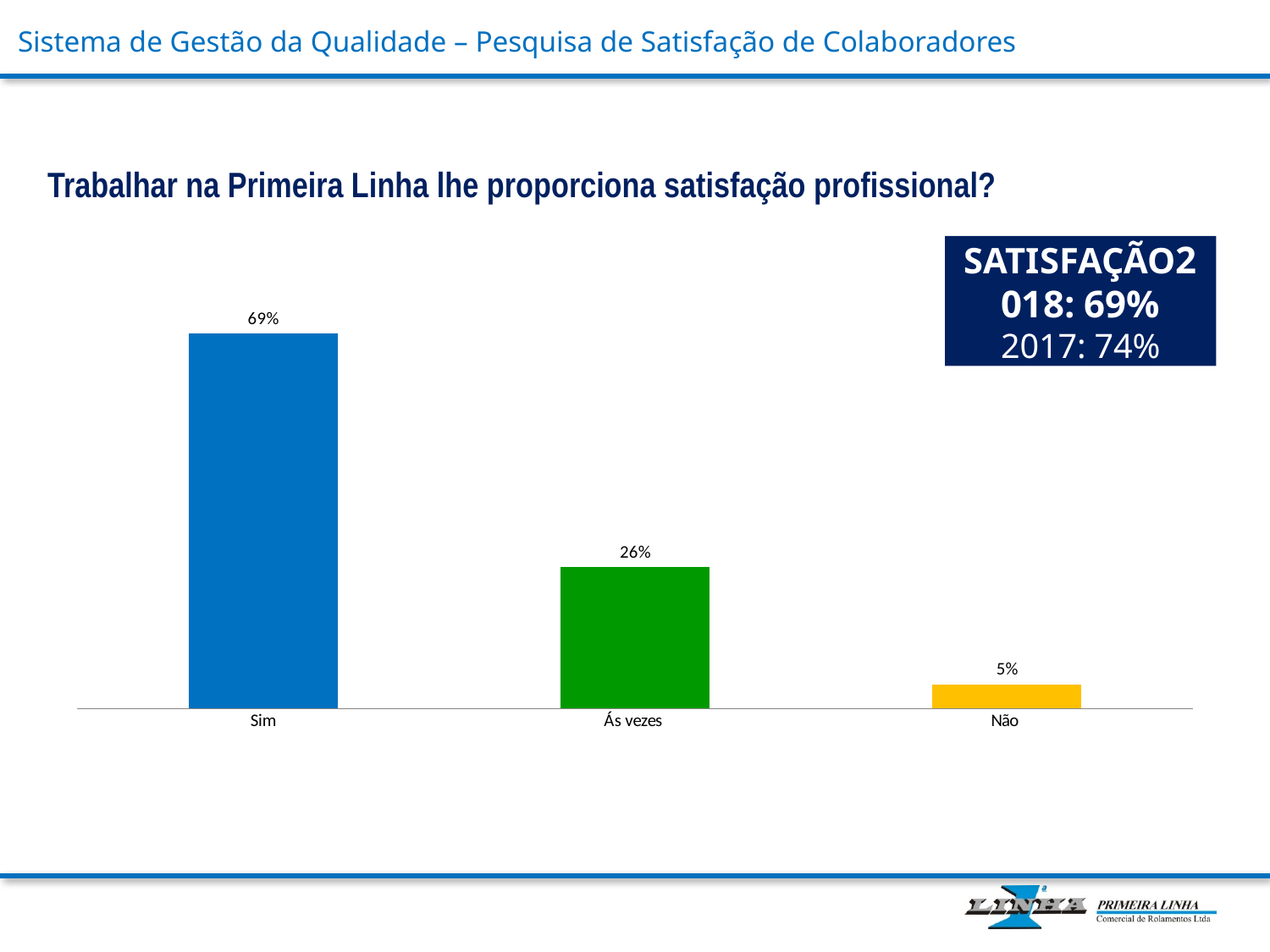
What is the difference between the values for "Sim" and "Ás vezes"? 43% What is the value for "Ás vezes"? 26% Which category has the lowest value? Não What colour is the bar for "Não"? Yellow What is the value for "Não"? 5% What is the difference between the values for "Ás vezes" and "Não"? 21% Do the values rise or fall from left to right across the categories? Fall Which is larger, the value for "Ás vezes" or the value for "Não"? Ás vezes What is the value for "Sim"? 69% Which category has the highest value? Sim How many categories are shown in the chart? 3 What kind of chart is shown on the slide? Bar chart